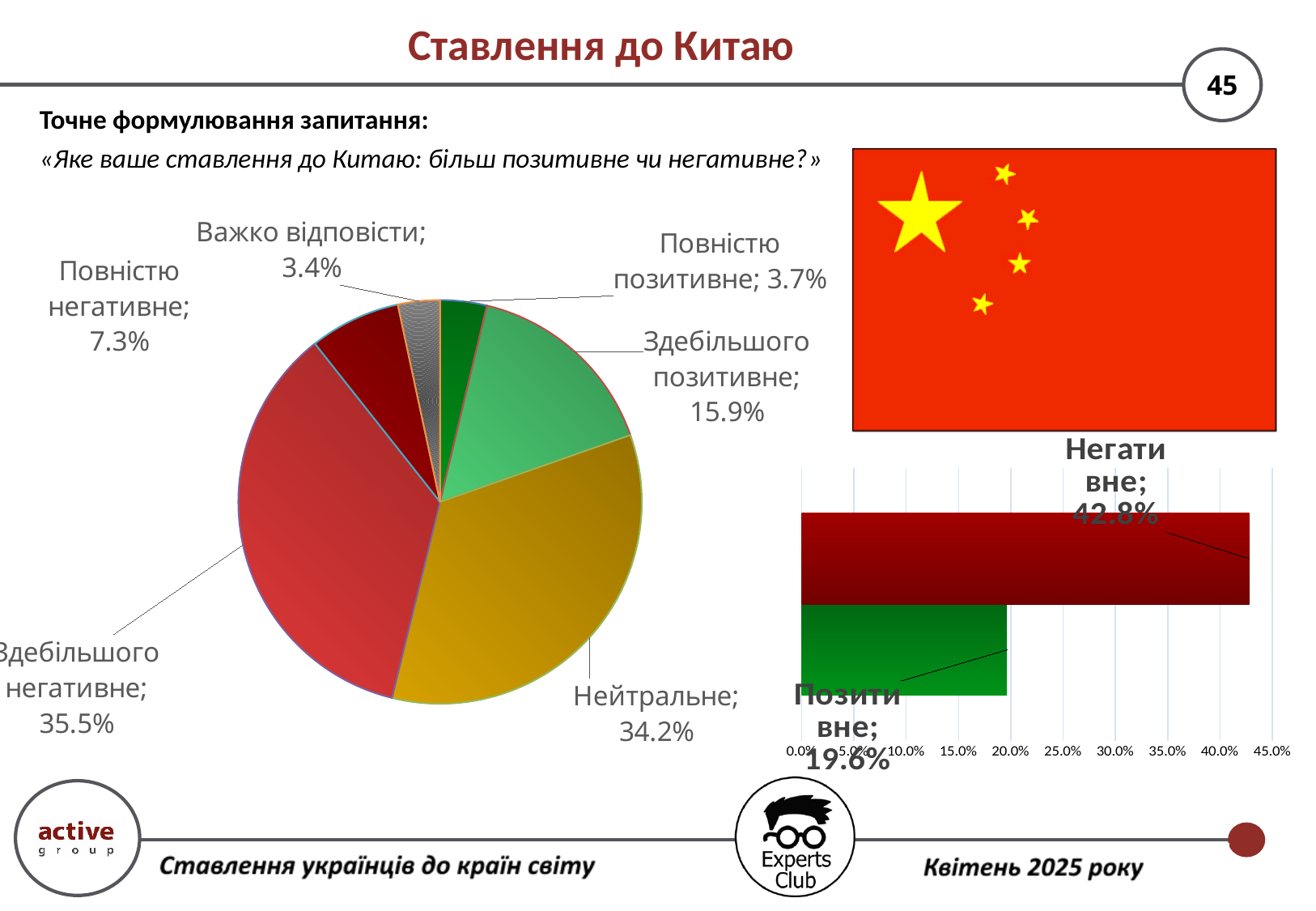
In the pie chart, which category has the largest share? Здебільшого негативне In the bar chart at the bottom right, what is the value for «Негативне»? 42.8% In the pie chart, what is the difference between «Здебільшого негативне» and «Здебільшого позитивне»? 19.6% In the bar chart at the bottom right, what is the value for «Позитивне»? 19.6% In the bar chart at the bottom right, what is the difference between «Негативне» and «Позитивне»? 23.2% In the pie chart, which is larger: «Повністю позитивне» or «Повністю негативне»? Повністю негативне What type of chart is shown at the bottom right of the slide? Bar chart In the pie chart, what share of respondents answered «Нейтральне»? 34.2% In the pie chart, what is the value for «Здебільшого позитивне»? 15.9% In the pie chart, how many slices are there? 6 In the pie chart, what is the value for «Повністю негативне»? 7.3% In the pie chart, which category has the smallest share? Важко відповісти